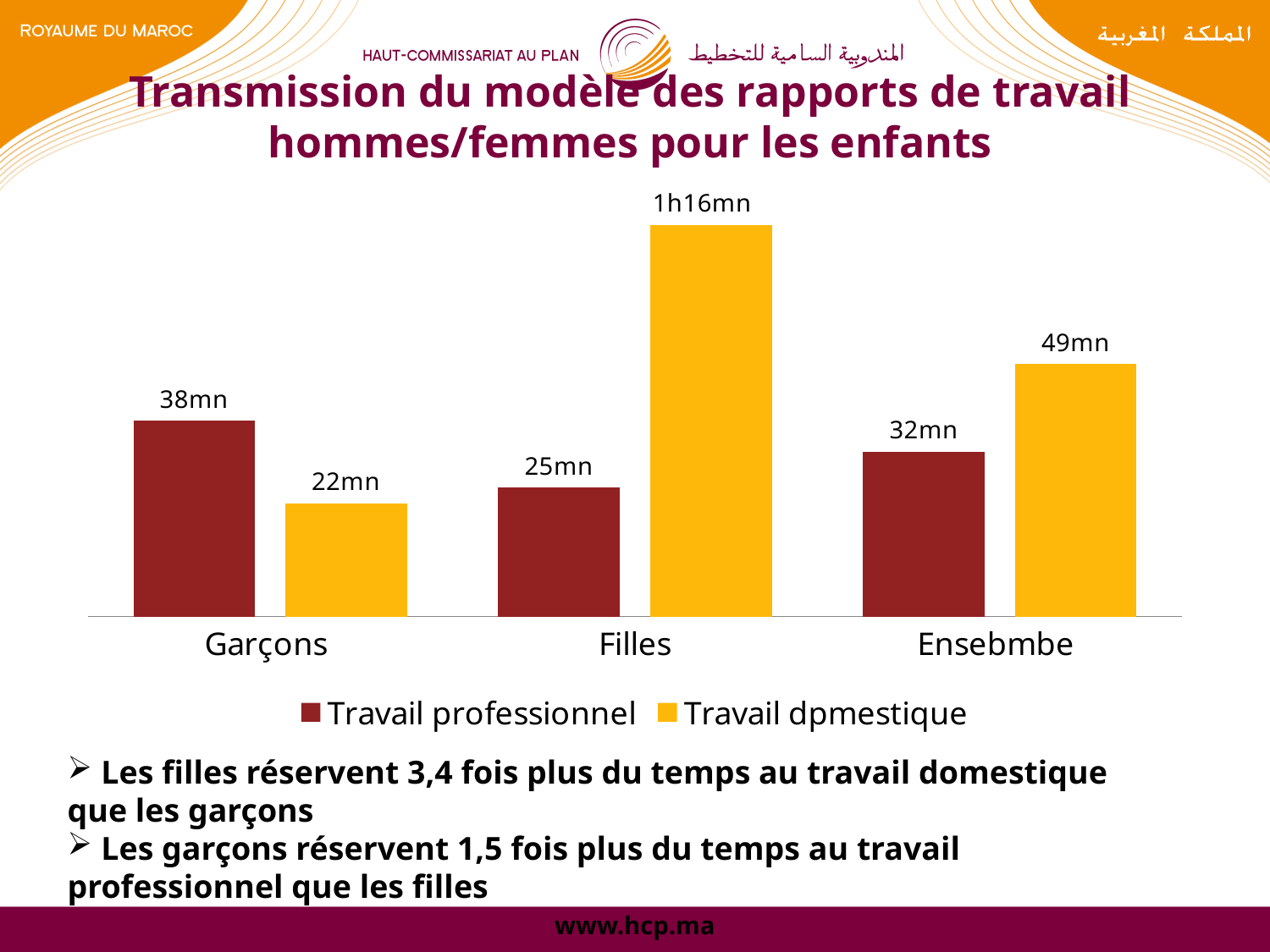
Which is larger for Ensebmbe: Travail professionnel or Travail dpmestique? Travail dpmestique Which category has the highest value for Travail dpmestique? Filles Which category has the lowest value for Travail professionnel? Filles What is the value of Travail professionnel for Garçons? 38mn What is the value of Travail professionnel for Filles? 25mn What is the value of Travail dpmestique for Filles? 1h16mn What is the difference between Travail professionnel and Travail dpmestique for Garçons? 16mn What is the value of Travail dpmestique for Ensebmbe? 49mn How many categories are shown on the x axis? 3 What kind of chart is shown on the slide? Bar chart How many series does the legend list? 2 Which colour represents Travail professionnel in the legend? Dark red